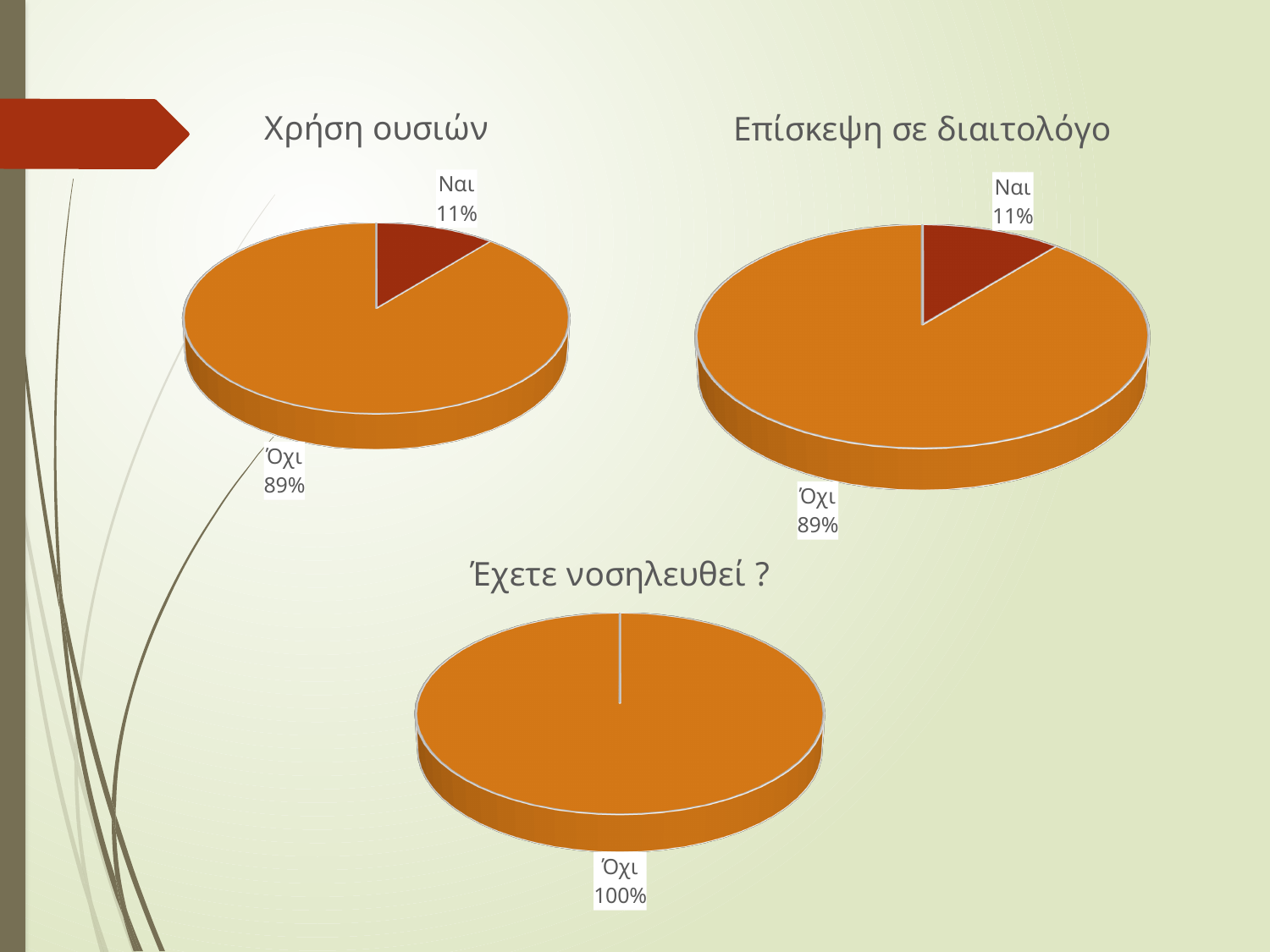
In the 'Επίσκεψη σε διαιτολόγο' chart, which category has the smallest share? Ναι In the 'Χρήση ουσιών' chart, what is the difference in percentage points between 'Όχι' and 'Ναι'? 78 In the 'Επίσκεψη σε διαιτολόγο' chart, what percentage is shown for 'Όχι'? 89% In the 'Έχετε νοσηλευθεί ?' chart, what percentage is shown for 'Όχι'? 100% In the 'Χρήση ουσιών' chart, what percentage is shown for 'Ναι'? 11% How many slices are labelled in the 'Έχετε νοσηλευθεί ?' chart? 1 In the 'Επίσκεψη σε διαιτολόγο' chart, which is larger, 'Ναι' or 'Όχι'? Όχι In the 'Χρήση ουσιών' chart, which category has the largest share? Όχι How many charts are shown on the slide? 3 In the 'Χρήση ουσιών' chart, what percentage is shown for 'Όχι'? 89% In the 'Επίσκεψη σε διαιτολόγο' chart, what percentage is shown for 'Ναι'? 11% What type of chart is the 'Χρήση ουσιών' chart? Pie chart